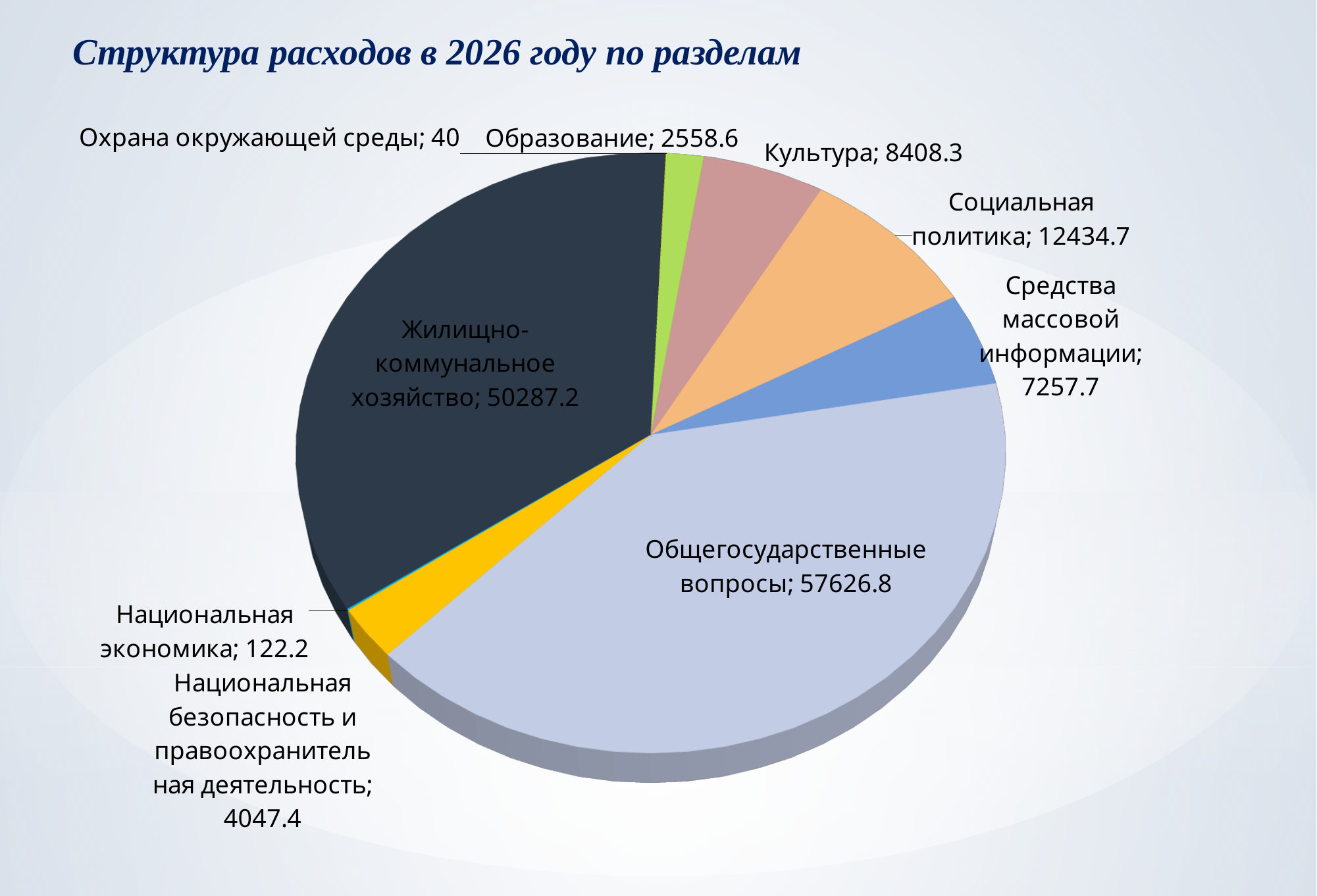
What is the difference between Общегосударственные вопросы and Жилищно-коммунальное хозяйство? 7339.6 What is the value for Социальная политика? 12434.7 What is the difference between Социальная политика and Культура? 4026.4 What kind of chart is shown on the slide? Pie chart What is the value for Охрана окружающей среды? 40 What is the value for Жилищно-коммунальное хозяйство? 50287.2 What is the title of the chart? Структура расходов в 2026 году по разделам How many categories (slices) does the pie chart have? 9 Which category has the largest value? Общегосударственные вопросы Which category has the smallest value? Охрана окружающей среды What is the value for Общегосударственные вопросы? 57626.8 Which is larger, Культура or Средства массовой информации? Культура